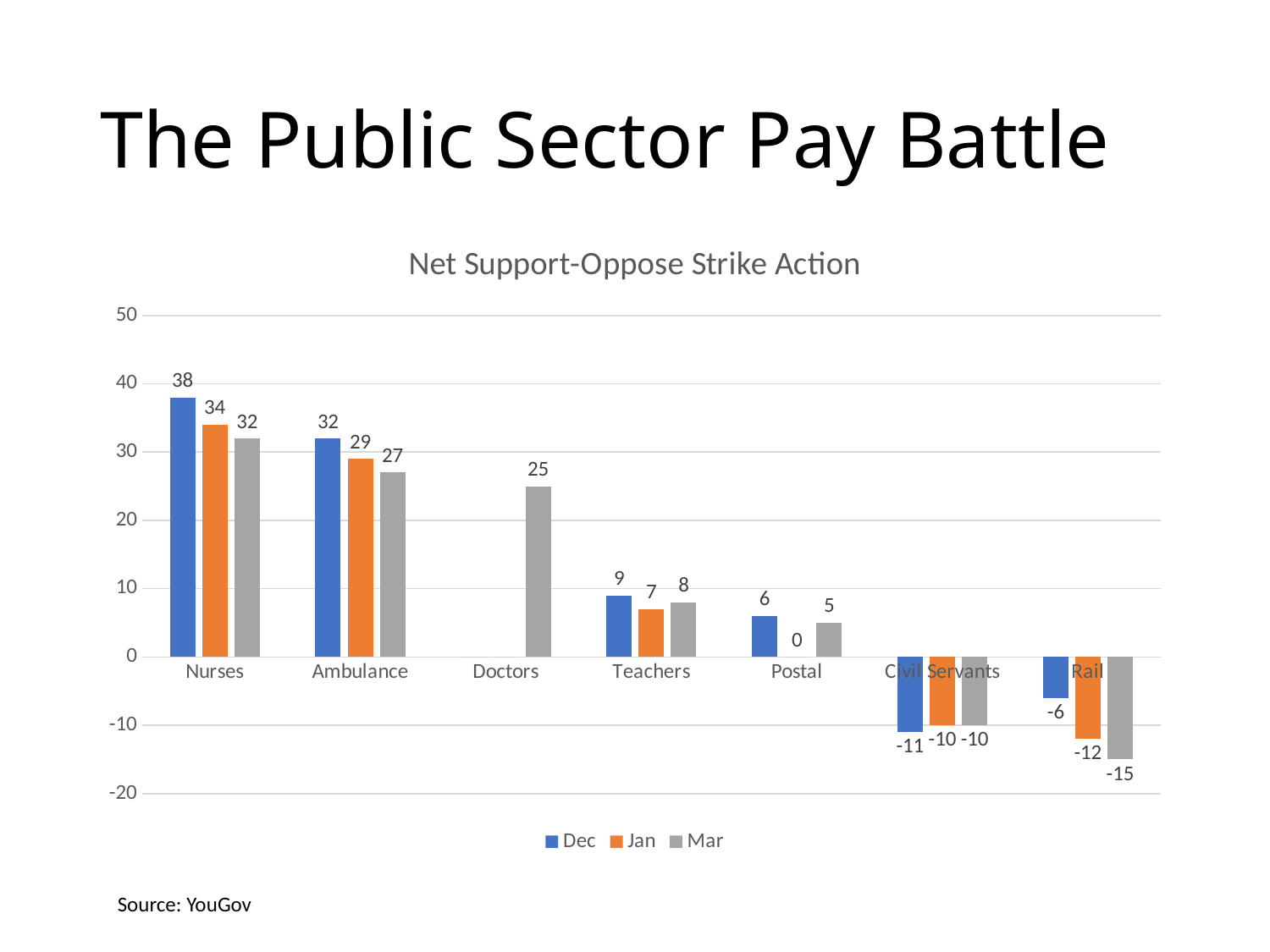
What is the Mar value for Rail? -15 How many categories are shown on the x axis? 7 Which is larger, the Jan value for Nurses or the Jan value for Ambulance? Nurses What is the Jan value for Postal? 0 What kind of chart is shown? Bar chart How many series does the legend list? 3 Which category has the lowest Mar value? Rail What is the title of the chart? Net Support-Oppose Strike Action What is the Dec value for Nurses? 38 Which category has the highest Dec value? Nurses What is the Mar value for Doctors? 25 What is the difference between the Dec and Mar values for Ambulance? 5